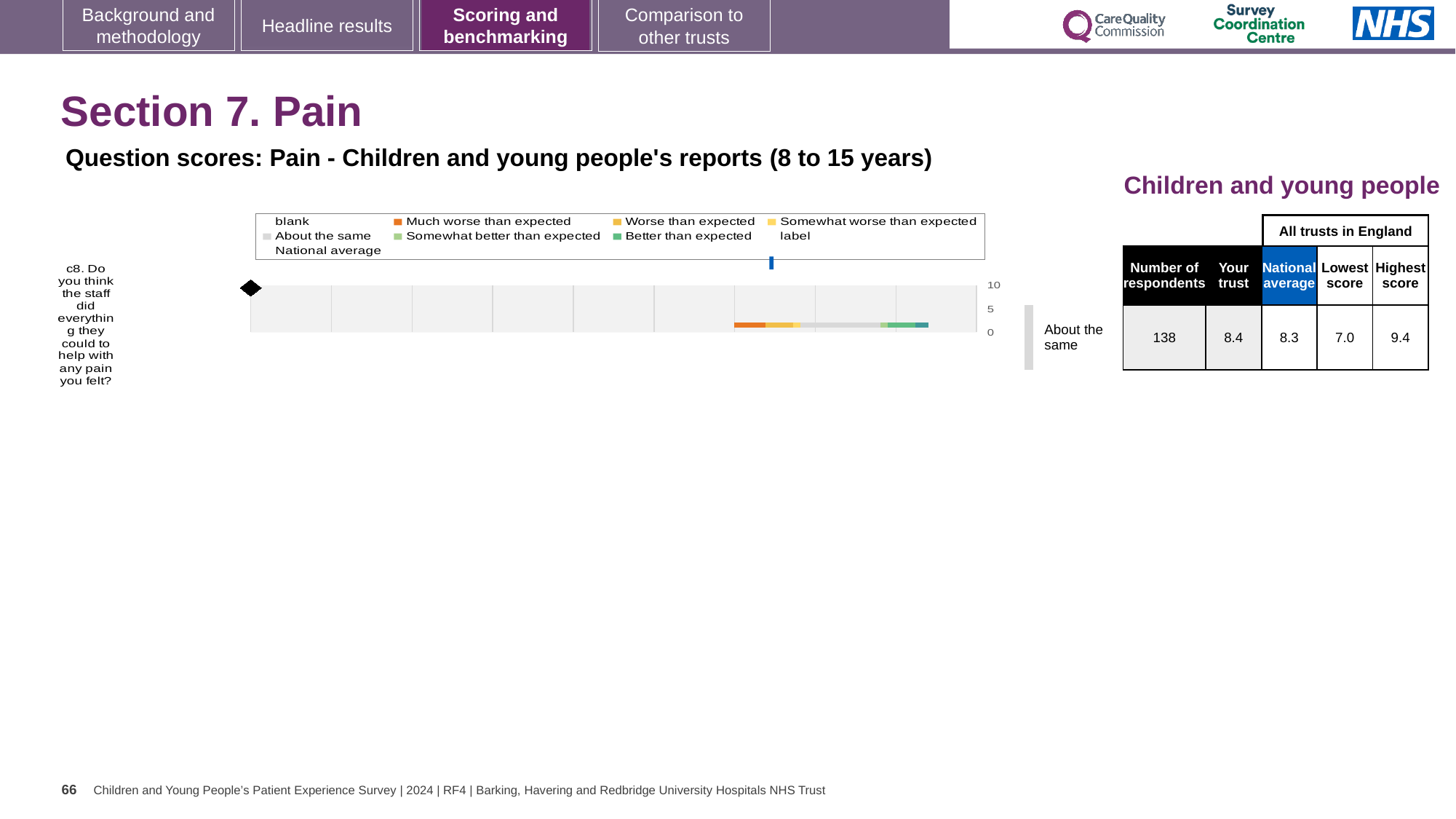
What kind of chart is shown on the slide? bar chart According to the table beside the chart, what is the lowest score among all trusts in England for question c8? 7.0 According to the table beside the chart, what is the 'Your trust' score for question c8? 8.4 What benchmark rating is given for question c8 next to the chart? About the same What is the difference between the highest score and the lowest score for question c8 in the table beside the chart? 2.4 How many respondents answered question c8, according to the table beside the chart? 138 What is the highest value shown on the chart's numeric axis? 10 According to the table beside the chart, what is the highest score among all trusts in England for question c8? 9.4 Which is larger for question c8: the 'Your trust' score or the national average? Your trust How many question categories are plotted on the chart? 1 Which legend entry is shown in orange? Much worse than expected According to the table beside the chart, what is the national average score for question c8? 8.3